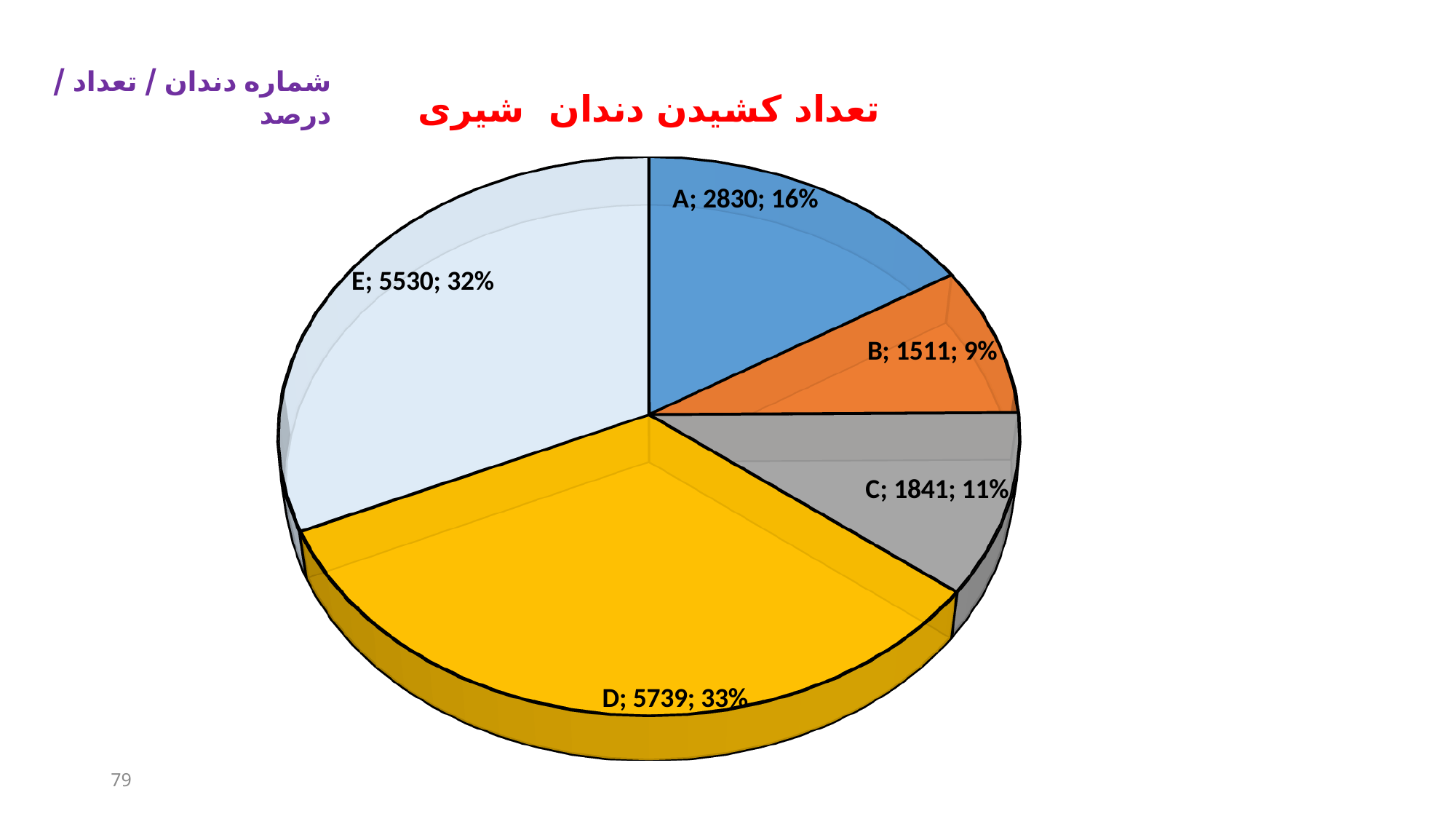
What is the value for slice A? 2830 What is the difference between the values of slice D and slice E? 209 Which is larger, the value for slice A or the value for slice C? A What kind of chart is shown on the slide? pie chart What is the value for slice C? 1841 What colour is slice D? yellow Which slice has the smallest value? B Which slice has the largest value? D What share of the pie does slice B represent? 9% How many slices does the pie chart have? 5 What is the value for slice E? 5530 What share of the pie does slice D represent? 33%